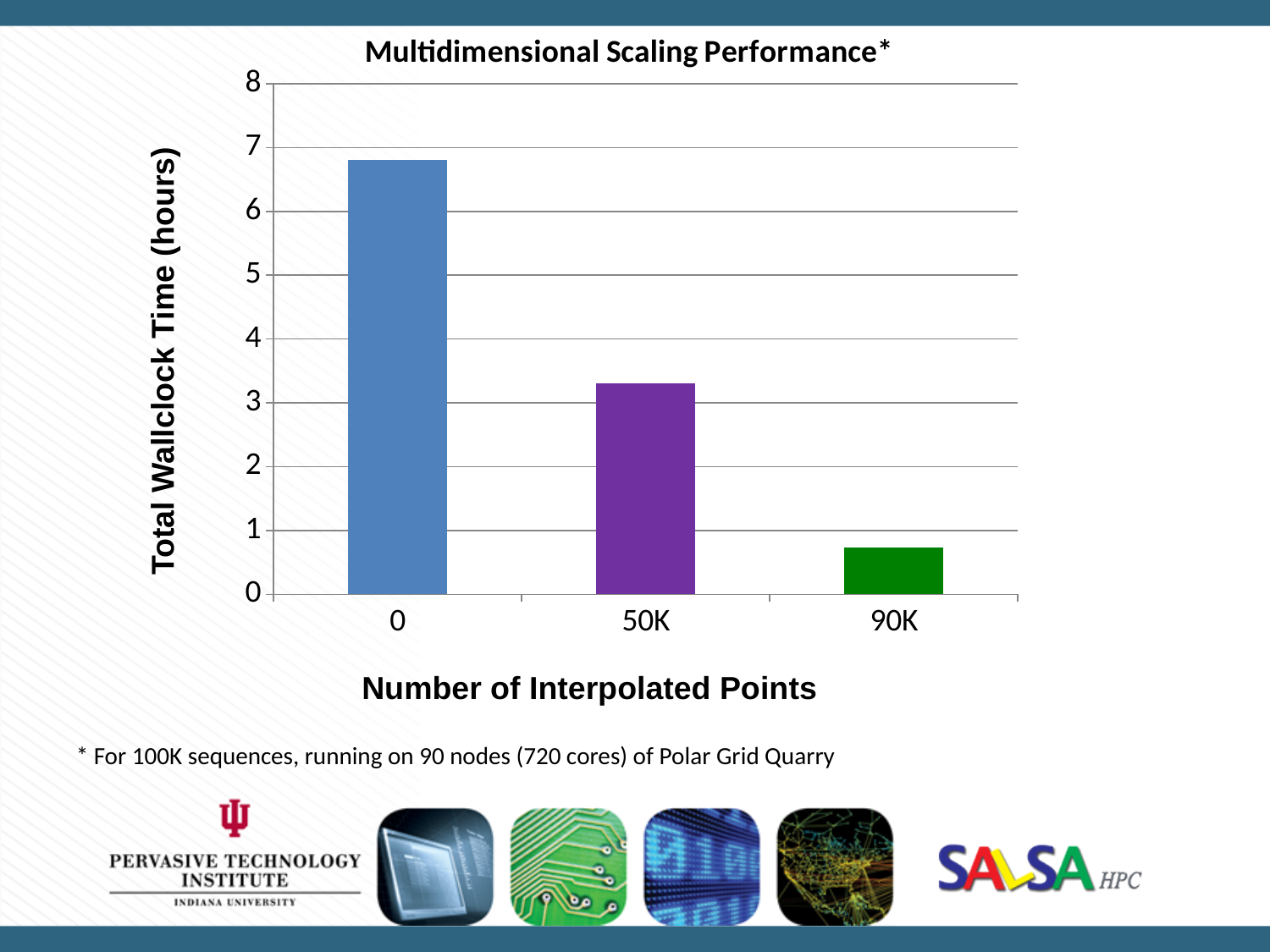
What is the label of the y axis? Total Wallclock Time (hours) What kind of chart is shown on the slide? bar chart How many categories are plotted on the x axis? 3 Which number of interpolated points has the lowest total wallclock time? 90K Does the total wallclock time rise or fall as the number of interpolated points increases along the x axis? fall What is the title of the chart? Multidimensional Scaling Performance* Which number of interpolated points has the highest total wallclock time? 0 Is the total wallclock time for 0 interpolated points greater or less than 6 hours? greater Which has a larger total wallclock time, 50K or 90K interpolated points? 50K Is the total wallclock time for 0 interpolated points greater or less than 7 hours? less Is the total wallclock time for 50K interpolated points greater or less than 3 hours? greater